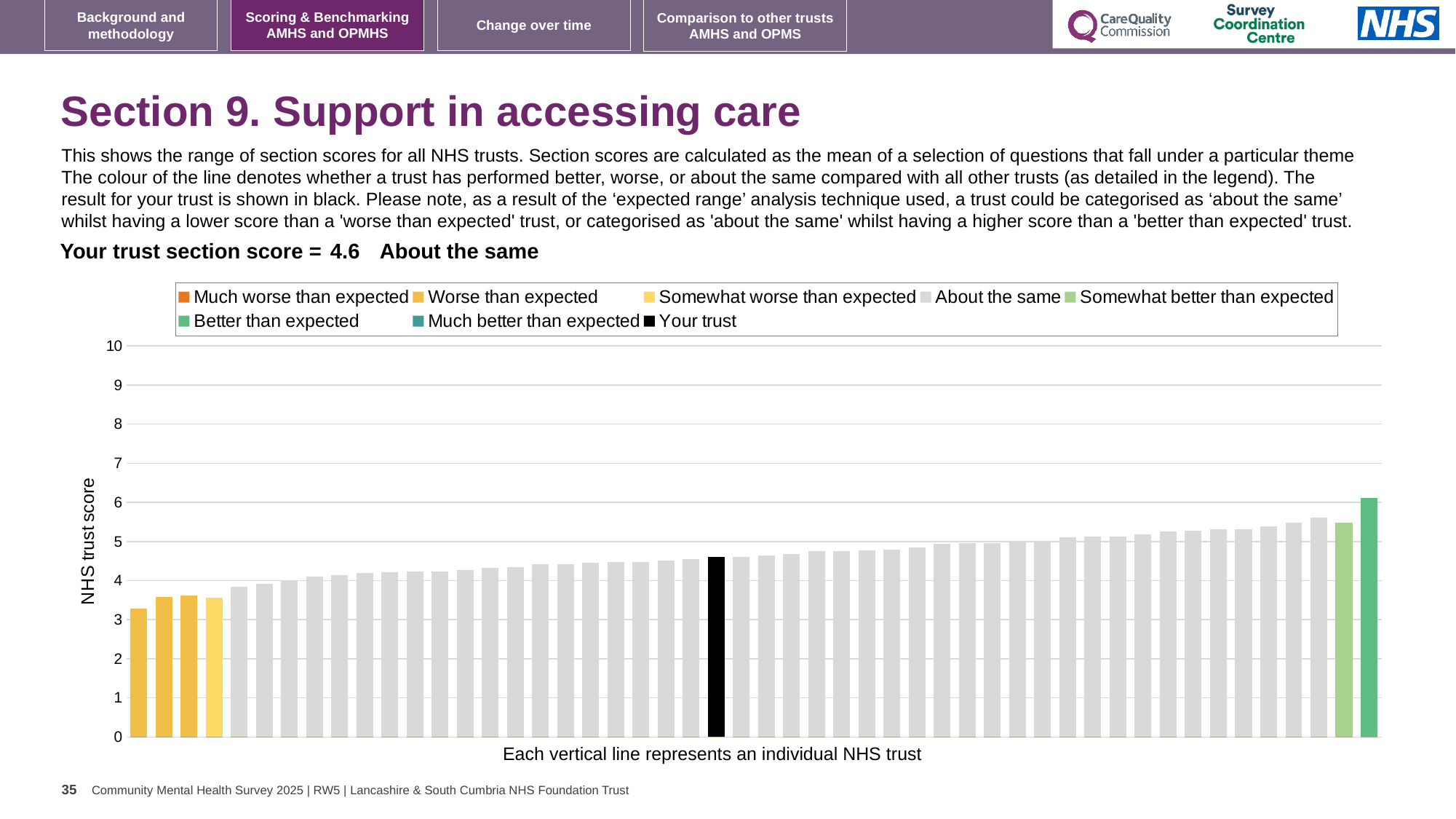
What colour is the bar representing your trust? black How many entries does the chart legend list? 8 Is the value of the lowest bar in the chart greater or less than 4? less Which legend category does the highest bar in the chart belong to? Better than expected Is the value of the highest bar in the chart greater or less than 5? greater Is the value of the lowest bar in the chart greater or less than 3? greater What kind of chart is shown on the slide? bar chart How many bars are coloured as 'Worse than expected' (yellow) in the chart? 3 Do the bar values rise or fall from left to right along the x axis? rise What is the section score for your trust shown on the slide? 4.6